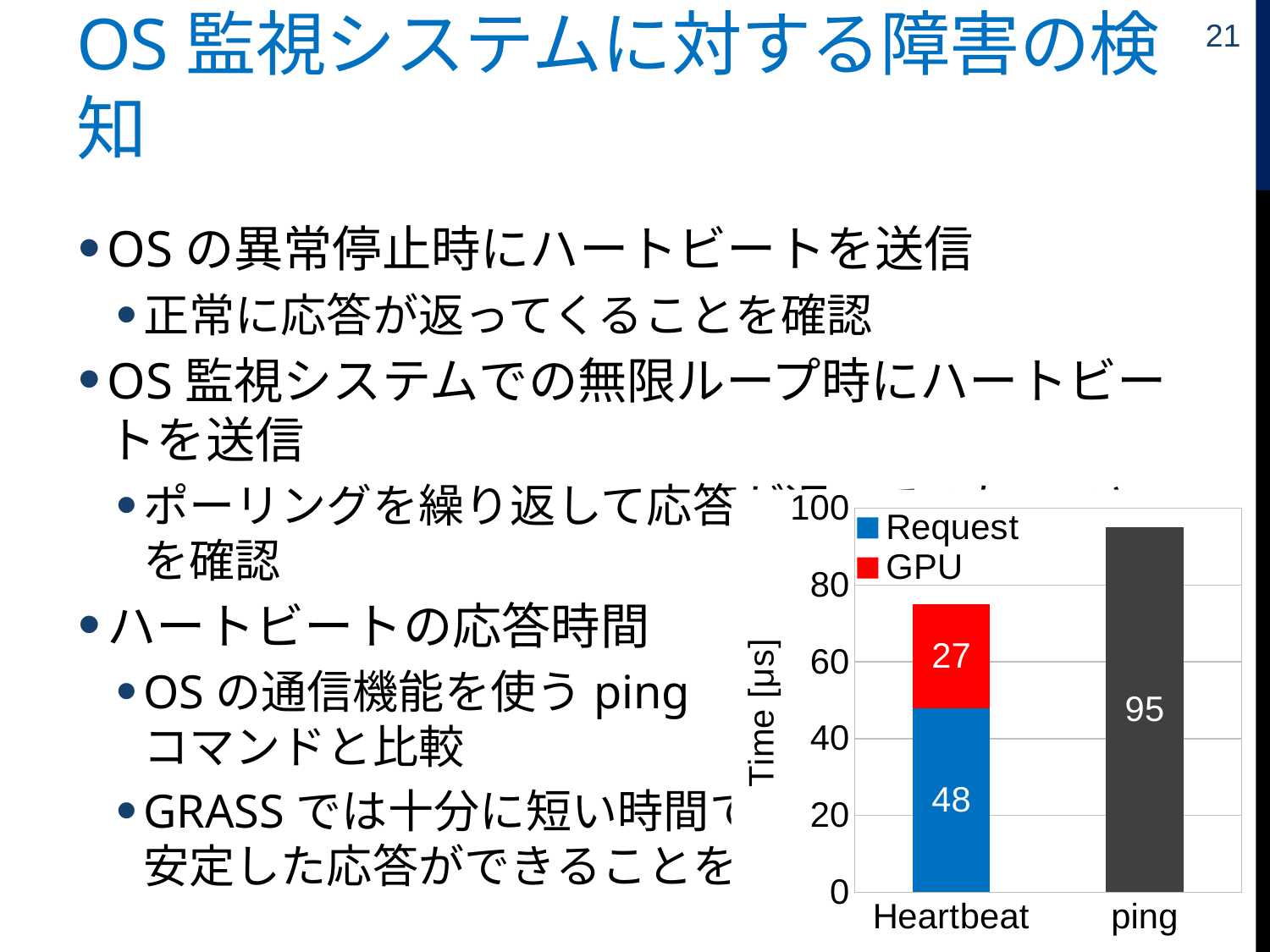
What is the GPU value for Heartbeat? 27 What is the total height of the stacked Heartbeat bar? 75 Which bar is taller, Heartbeat or ping? ping What is the difference between the ping value and the Request value for Heartbeat? 47 What kind of chart is shown on the slide? Stacked bar chart Is the total for Heartbeat greater or less than 80? less How many categories are shown on the x axis? 2 What is the label of the y axis? Time [µs] What is the value shown for ping? 95 How many series does the legend list? 2 What is the Request value for Heartbeat? 48 What is the difference between the Request and GPU values for Heartbeat? 21